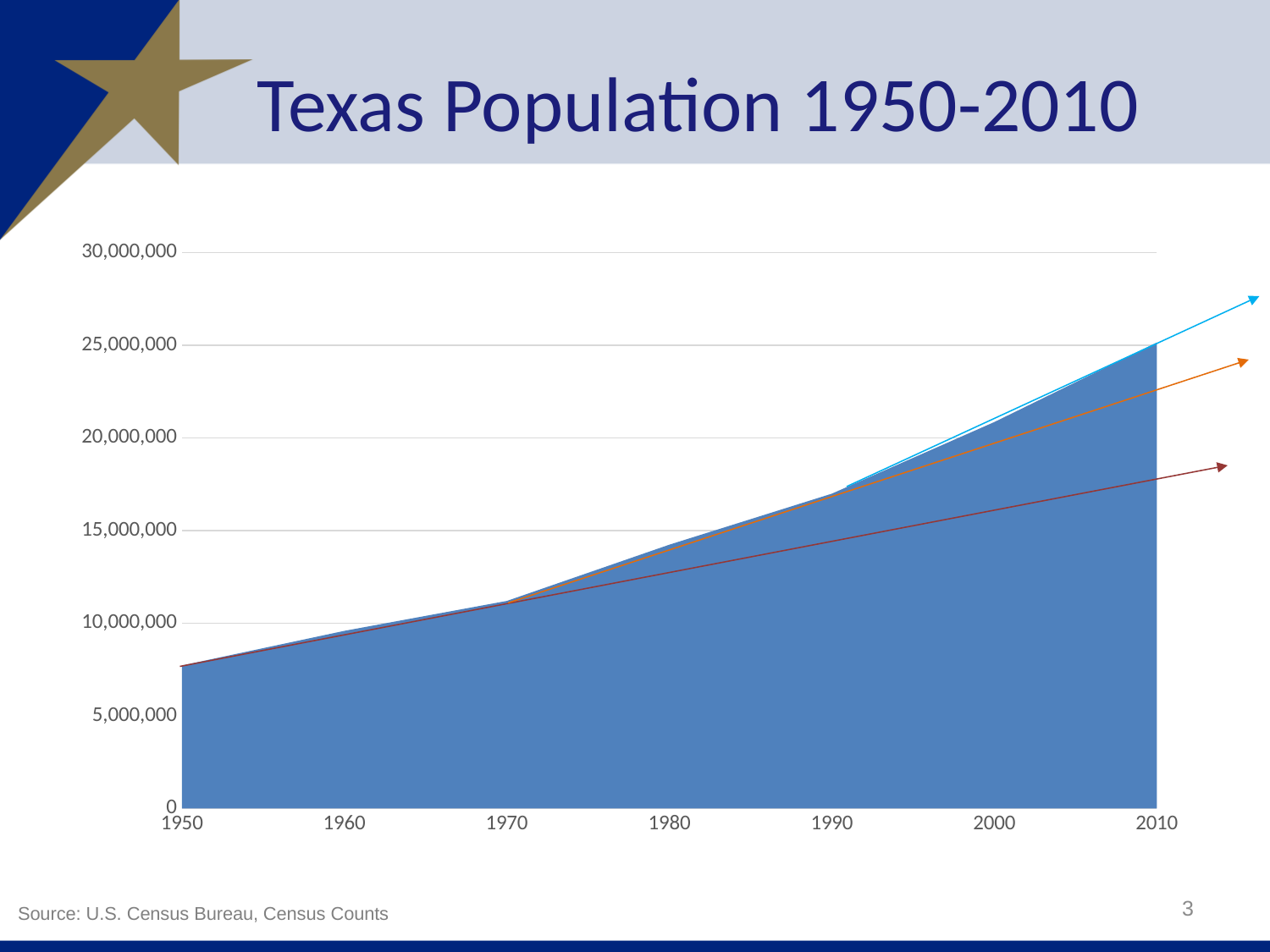
Is the population value for 2000 greater or less than 25,000,000? less Is the population value for 1990 greater or less than 15,000,000? greater Is the population value for 2010 greater or less than 20,000,000? greater Which year has the highest population value on the chart? 2010 Which year has the lowest population value on the chart? 1950 What is the title of the chart? Texas Population 1950-2010 Which year has the larger population value, 1970 or 2000? 2000 What kind of chart is shown on the slide? area chart Does the Texas population rise or fall from 1950 to 2010? rise How many years are labelled on the x axis of the chart? 7 What source is cited for the chart data? U.S. Census Bureau, Census Counts